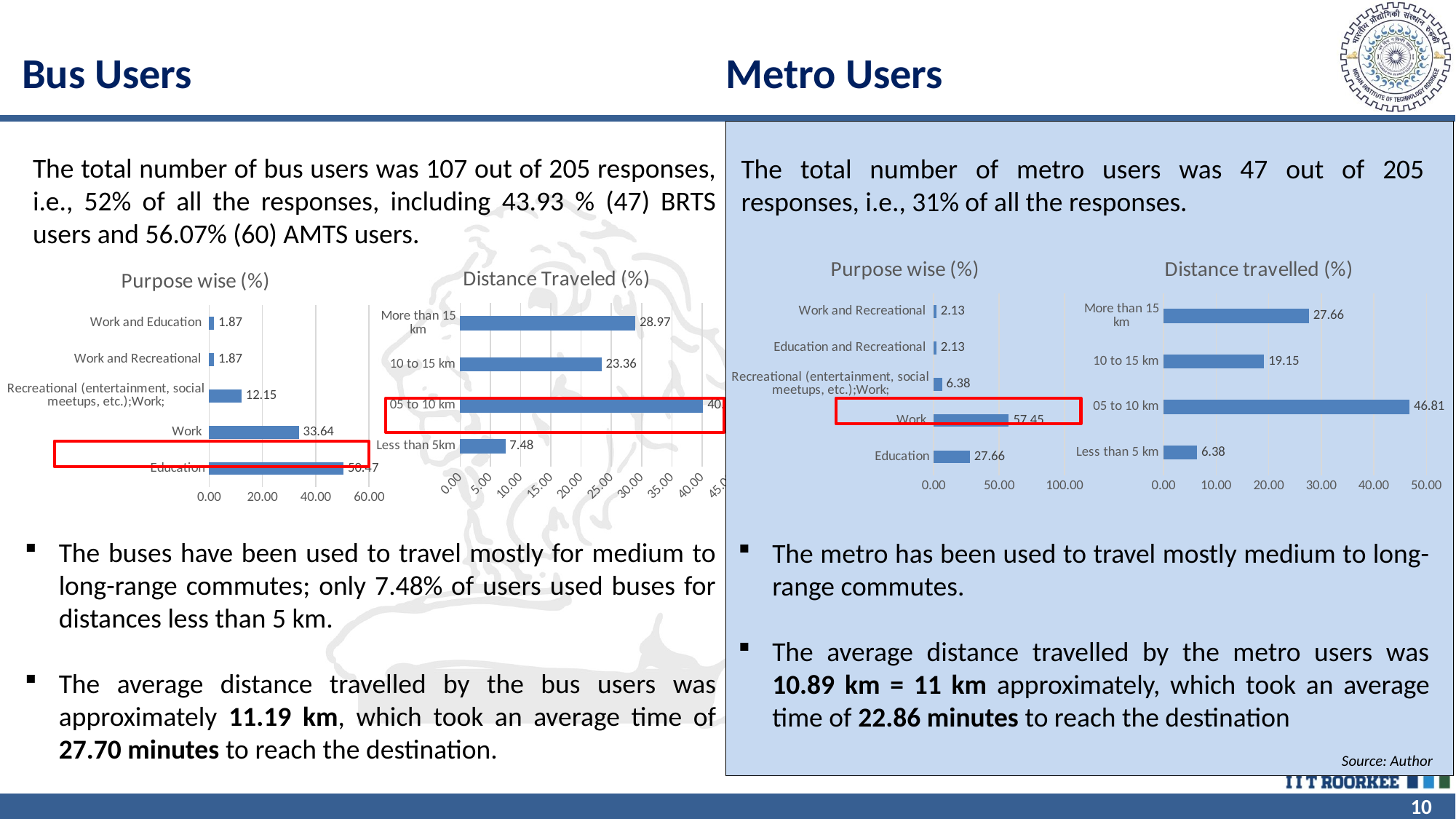
In the Metro Users 'Purpose wise (%)' chart, what is the value for 'Education'? 27.66 In the Metro Users 'Distance travelled (%)' chart, what is the value for '05 to 10 km'? 46.81 In the Bus Users 'Purpose wise (%)' chart, which category has the highest value? Education In the Metro Users 'Distance travelled (%)' chart, what is the difference between '05 to 10 km' and '10 to 15 km'? 27.66 In the Bus Users 'Purpose wise (%)' chart, what is the value for 'Work'? 33.64 In the Bus Users 'Distance Traveled (%)' chart, which distance band has the highest value? 05 to 10 km How many categories are shown in the Metro Users 'Purpose wise (%)' chart? 5 In the Bus Users 'Distance Traveled (%)' chart, what is the value for 'More than 15 km'? 28.97 In the Bus Users 'Distance Traveled (%)' chart, what is the value for 'Less than 5km'? 7.48 In the Metro Users 'Purpose wise (%)' chart, what is the value for 'Work'? 57.45 In the Metro Users 'Distance travelled (%)' chart, which distance band has the lowest value? Less than 5 km In the Bus Users 'Distance Traveled (%)' chart, what is the difference between 'More than 15 km' and '10 to 15 km'? 5.61